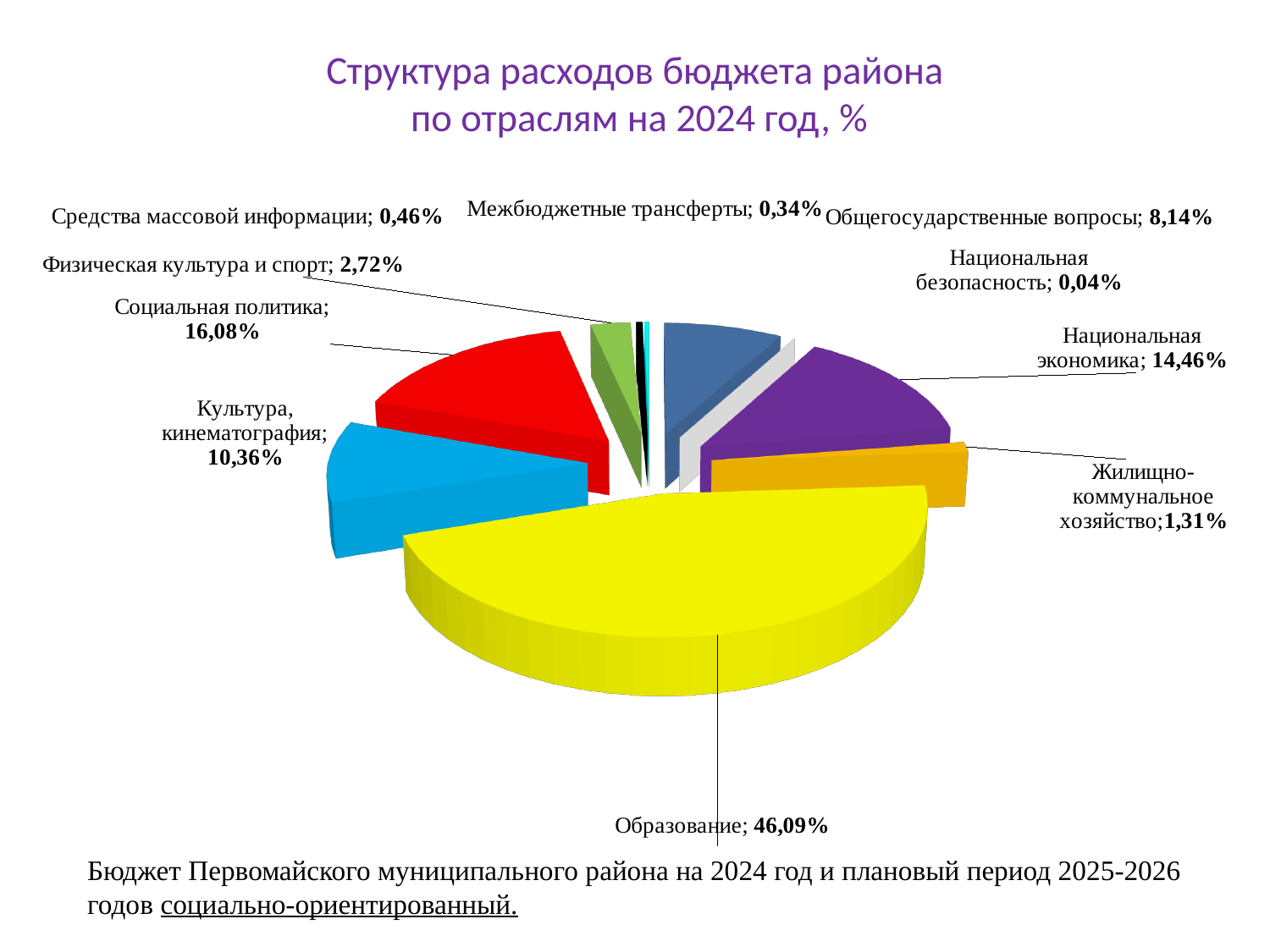
What is the share for Образование? 46,09% Which category has the largest share of the pie? Образование Which category has the smallest share of the pie? Национальная безопасность What is the share for Жилищно-коммунальное хозяйство? 1,31% Which is larger, the share for Общегосударственные вопросы or the share for Физическая культура и спорт? Общегосударственные вопросы What kind of chart is shown on the slide? Pie chart How many categories are shown in the pie chart? 10 What is the difference between the shares of Социальная политика and Культура, кинематография? 5,72% What is the title of the chart? Структура расходов бюджета района по отраслям на 2024 год, % What is the share for Межбюджетные трансферты? 0,34% What is the share for Национальная экономика? 14,46% What is the share for Социальная политика? 16,08%